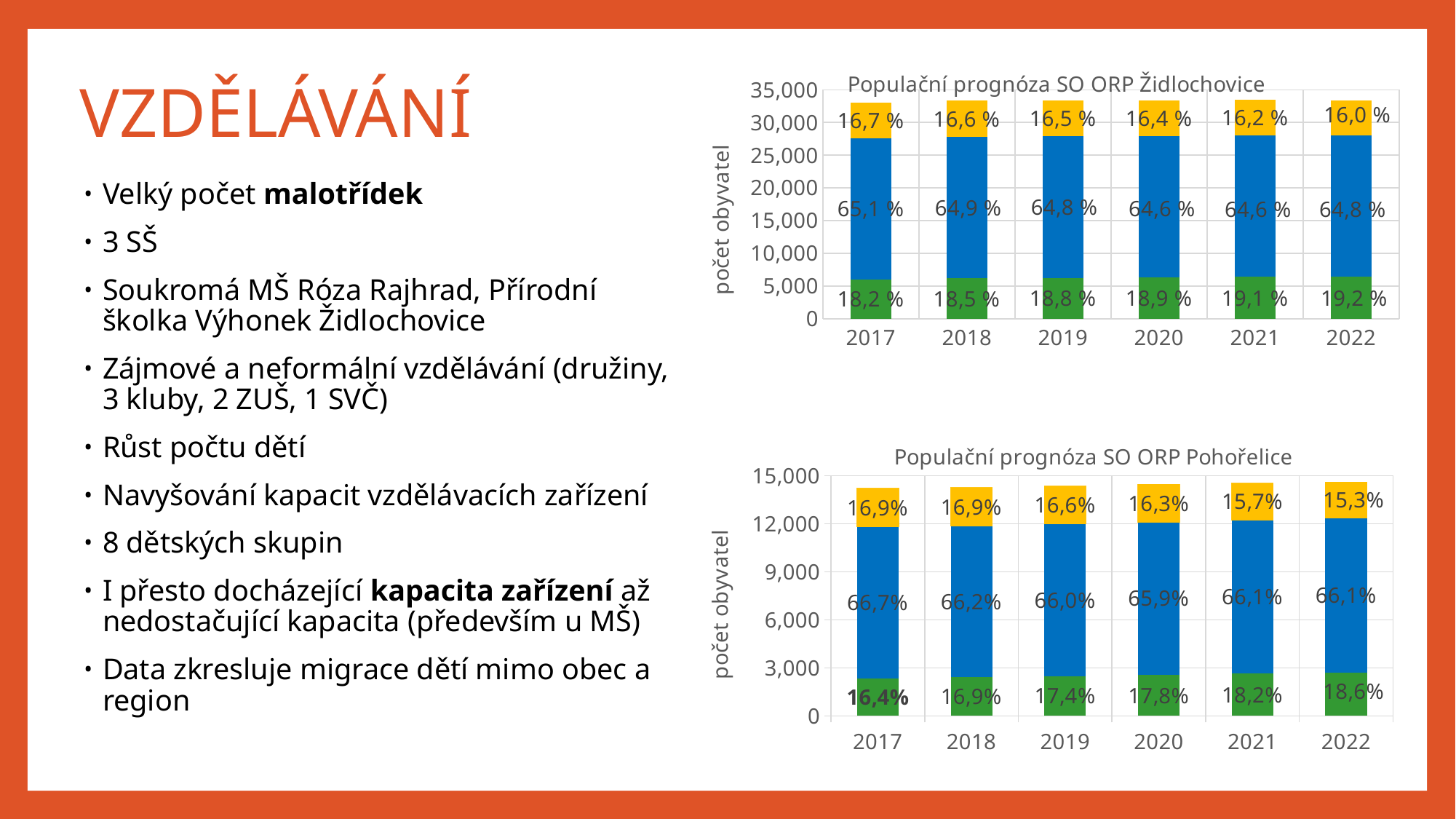
How many years are shown on the x axis of the chart titled "Populační prognóza SO ORP Pohořelice"? 6 In the chart titled "Populační prognóza SO ORP Pohořelice", does the percentage on the green (bottom) segment rise or fall from 2017 to 2022? rise In the chart titled "Populační prognóza SO ORP Pohořelice", by how many percentage points does the green (bottom) segment label for 2022 exceed that for 2017? 2,2 In the chart titled "Populační prognóza SO ORP Židlochovice", is the yellow (top) segment percentage larger in 2017 or in 2021? 2017 In the chart titled "Populační prognóza SO ORP Pohořelice", which year has the lowest percentage on the yellow (top) segment? 2022 In the chart titled "Populační prognóza SO ORP Židlochovice", which year has the highest percentage on the green (bottom) segment? 2022 In the chart titled "Populační prognóza SO ORP Pohořelice", what percentage is shown on the blue (middle) segment for 2017? 66,7% In the chart titled "Populační prognóza SO ORP Pohořelice", is the top of the green (bottom) segment for 2017 greater or less than 3,000? less In the chart titled "Populační prognóza SO ORP Židlochovice", what percentage is shown on the green (bottom) segment for 2017? 18,2 % In the chart titled "Populační prognóza SO ORP Pohořelice", what percentage is shown on the green (bottom) segment for 2022? 18,6% In the chart titled "Populační prognóza SO ORP Židlochovice", what percentage is shown on the yellow (top) segment for 2022? 16,0 % In the chart titled "Populační prognóza SO ORP Židlochovice", is the total height of the 2020 bar greater or less than 30,000? greater